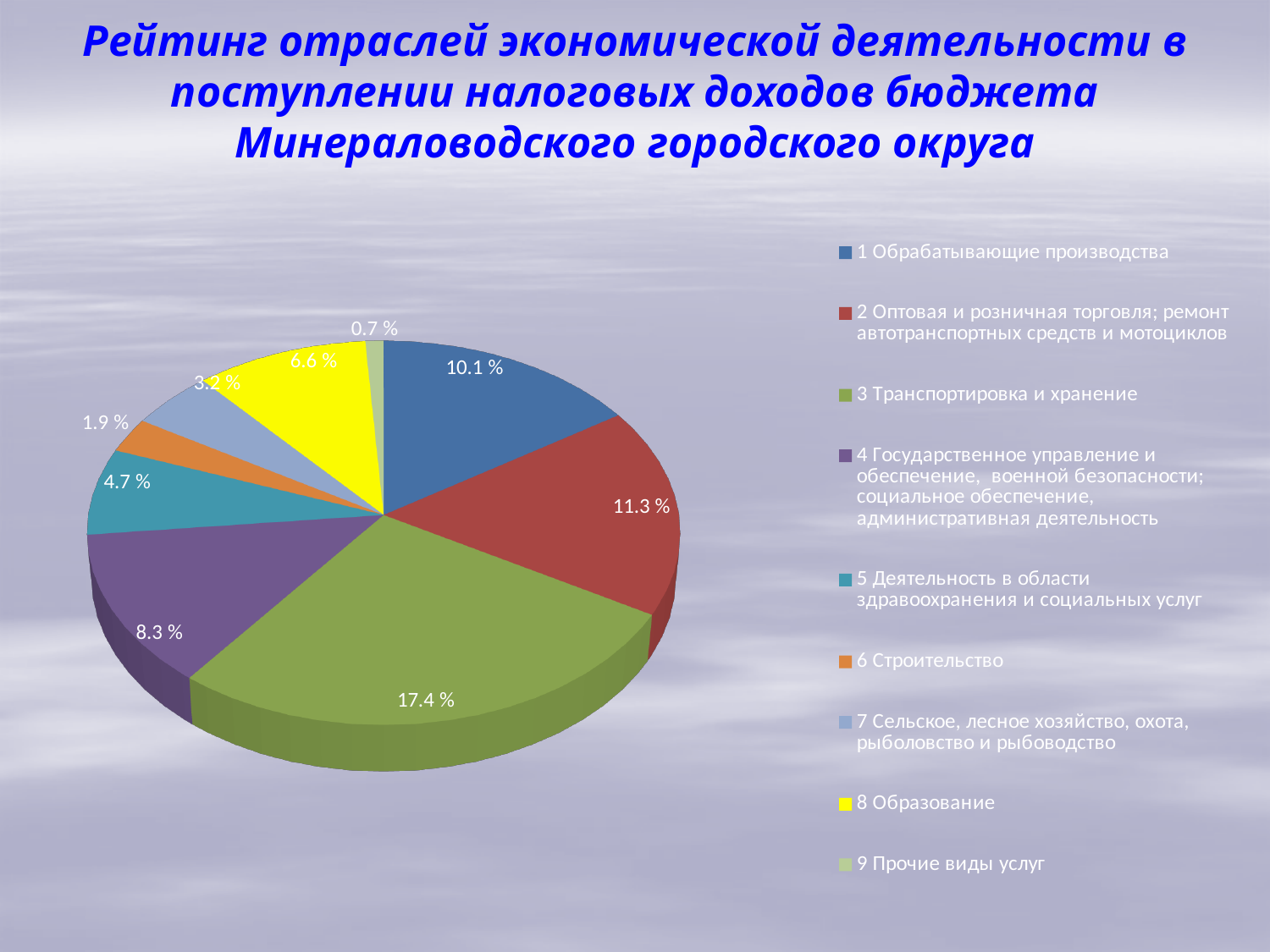
What is the value for "Образование"? 6.6 % What type of chart is shown on the slide? pie chart What is the value for "Транспортировка и хранение"? 17.4 % What is the value for "Обрабатывающие производства"? 10.1 % How many categories does the legend list? 9 What is the value for "Строительство"? 1.9 % What colour is the slice for "Образование"? yellow Which category has the largest slice? Транспортировка и хранение Which is larger: the value for "Государственное управление и обеспечение, военной безопасности; социальное обеспечение, административная деятельность" or the value for "Деятельность в области здравоохранения и социальных услуг"? Государственное управление и обеспечение, военной безопасности; социальное обеспечение, административная деятельность What is the value for "Сельское, лесное хозяйство, охота, рыболовство и рыбоводство"? 3.2 % What is the difference between the values for "Оптовая и розничная торговля; ремонт автотранспортных средств и мотоциклов" and "Обрабатывающие производства"? 1.2 % Which category has the smallest slice? Прочие виды услуг